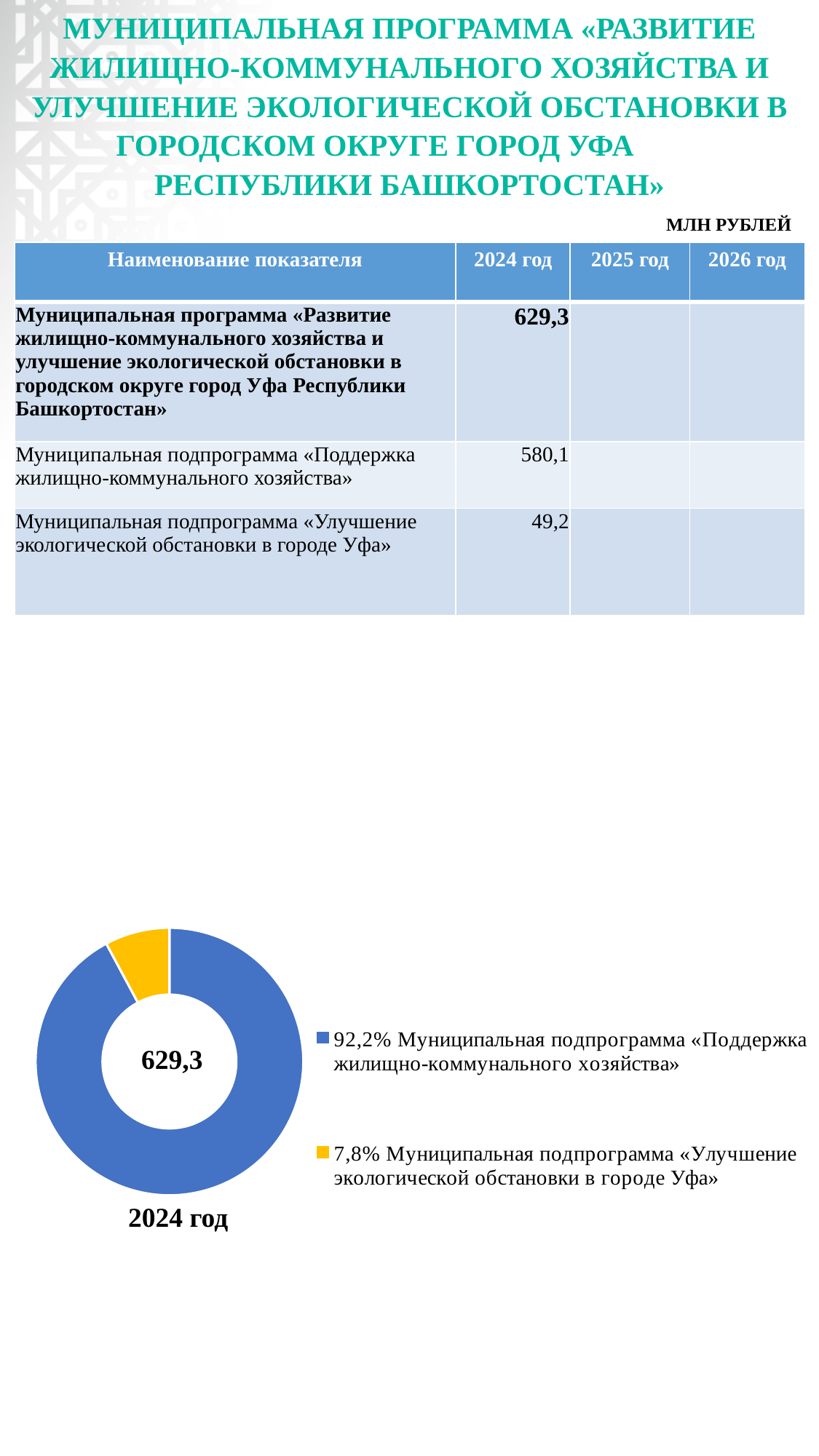
What colour is the slice for «Улучшение экологической обстановки в городе Уфа» in the doughnut chart? Yellow What share of the doughnut chart does «Улучшение экологической обстановки в городе Уфа» take? 7,8% What is the difference in percentage points between the two slices of the doughnut chart? 84,4 Which subprogram has the largest slice in the doughnut chart? Муниципальная подпрограмма «Поддержка жилищно-коммунального хозяйства» How many slices does the doughnut chart have? 2 In the doughnut chart, which slice is larger: «Поддержка жилищно-коммунального хозяйства» or «Улучшение экологической обстановки в городе Уфа»? «Поддержка жилищно-коммунального хозяйства» What share of the doughnut chart does «Поддержка жилищно-коммунального хозяйства» take? 92,2% Which subprogram has the smallest slice in the doughnut chart? Муниципальная подпрограмма «Улучшение экологической обстановки в городе Уфа» What kind of chart is shown at the bottom of the slide? Pie chart (doughnut) What total value is printed in the centre of the doughnut chart? 629,3 Which year does the doughnut chart represent, according to the label beneath it? 2024 год How many entries does the legend of the doughnut chart list? 2